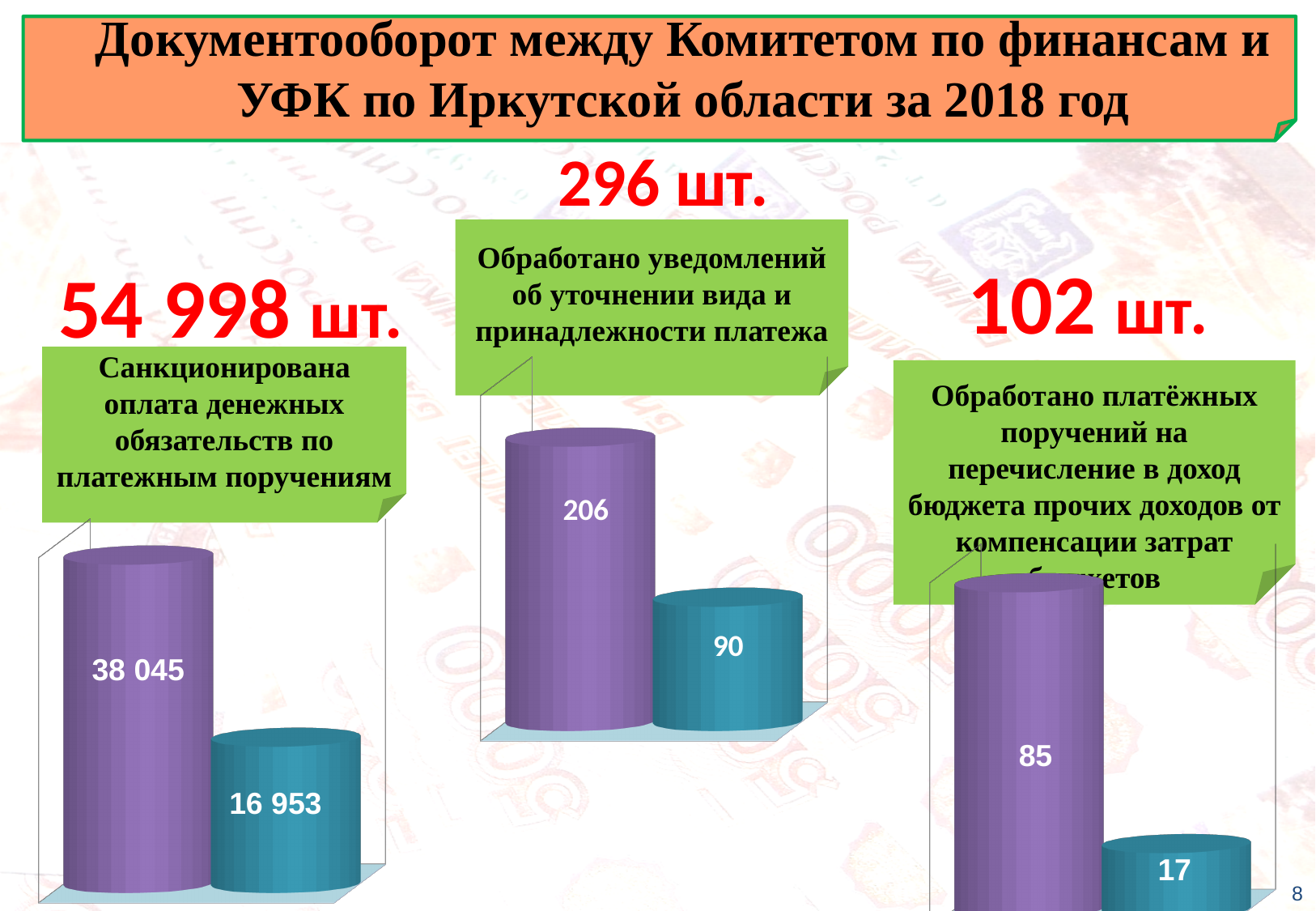
On the right chart, which bar is larger, the purple one or the teal one? the purple one On the left chart, what is the difference between the purple bar and the teal bar? 21 092 On the middle chart (Обработано уведомлений об уточнении вида и принадлежности платежа), what is the value of the purple bar? 206 What total figure is printed above the right chart? 102 шт. On the right chart (Обработано платёжных поручений на перечисление в доход бюджета), what is the value of the purple bar? 85 How many bars does the middle chart show? 2 What kind of chart is the left chart? bar chart On the left chart (Санкционирована оплата денежных обязательств по платежным поручениям), what is the value of the purple bar? 38 045 On the middle chart, what is the value of the teal bar? 90 On the middle chart, what is the difference between the purple bar and the teal bar? 116 On the left chart, what is the value of the teal bar? 16 953 On the right chart, what is the value of the teal bar? 17